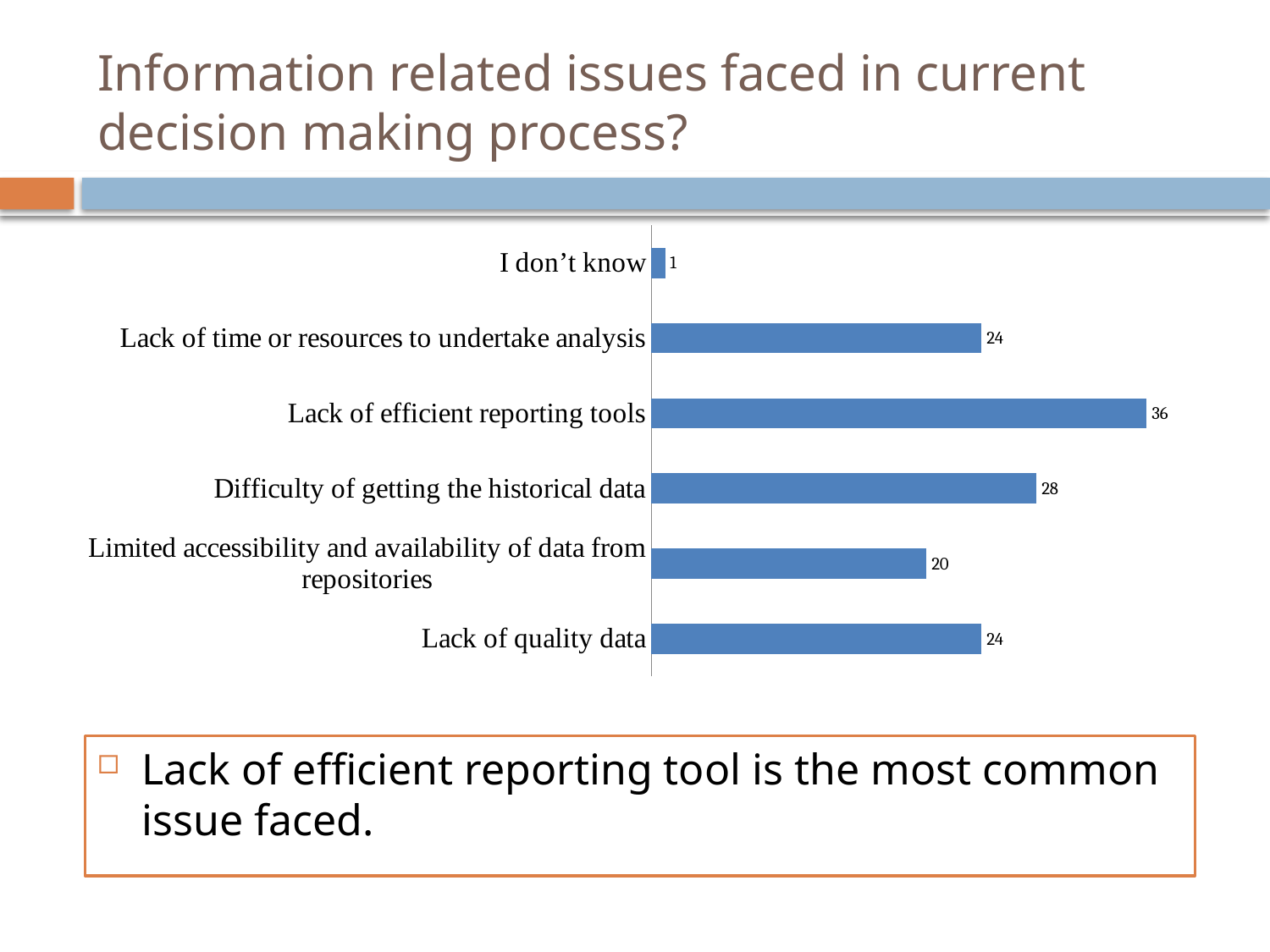
Which category has the highest value? Lack of efficient reporting tools What kind of chart is shown on the slide? Bar chart What is the value for "Lack of efficient reporting tools"? 36 What is the value for "Difficulty of getting the historical data"? 28 What is the difference between the values for "Lack of quality data" and "I don't know"? 23 What is the difference between the values for "Lack of efficient reporting tools" and "Difficulty of getting the historical data"? 8 How many categories are shown in the chart? 6 Which category has the lowest value? I don't know What is the value for "I don't know"? 1 What is the value for "Limited accessibility and availability of data from repositories"? 20 Which is larger: the value for "Lack of time or resources to undertake analysis" or the value for "Limited accessibility and availability of data from repositories"? Lack of time or resources to undertake analysis What is the value for "Lack of quality data"? 24